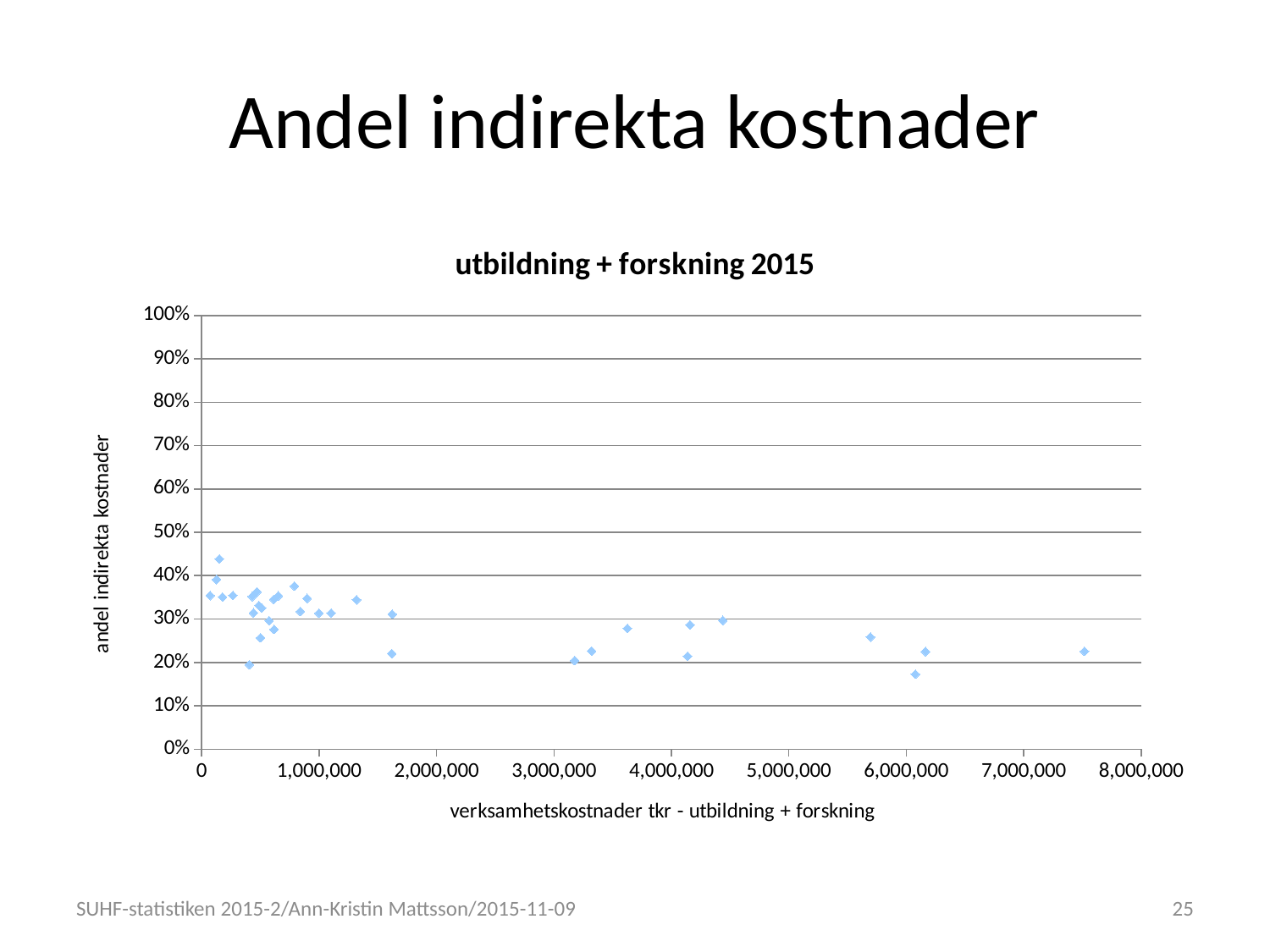
Is the value of the point plotted at about 3,600,000 on the x axis greater or less than 20%? greater Is the lowest point on the chart greater or less than 20%? less Is the value of the point plotted at about 4,400,000 on the x axis greater or less than 20%? greater What is the title of the chart? utbildning + forskning 2015 What kind of chart is shown on the slide? scatter chart Do the plotted values generally rise or fall as the x-axis value increases? fall What is the label of the x axis of the chart? verksamhetskostnader tkr - utbildning + forskning